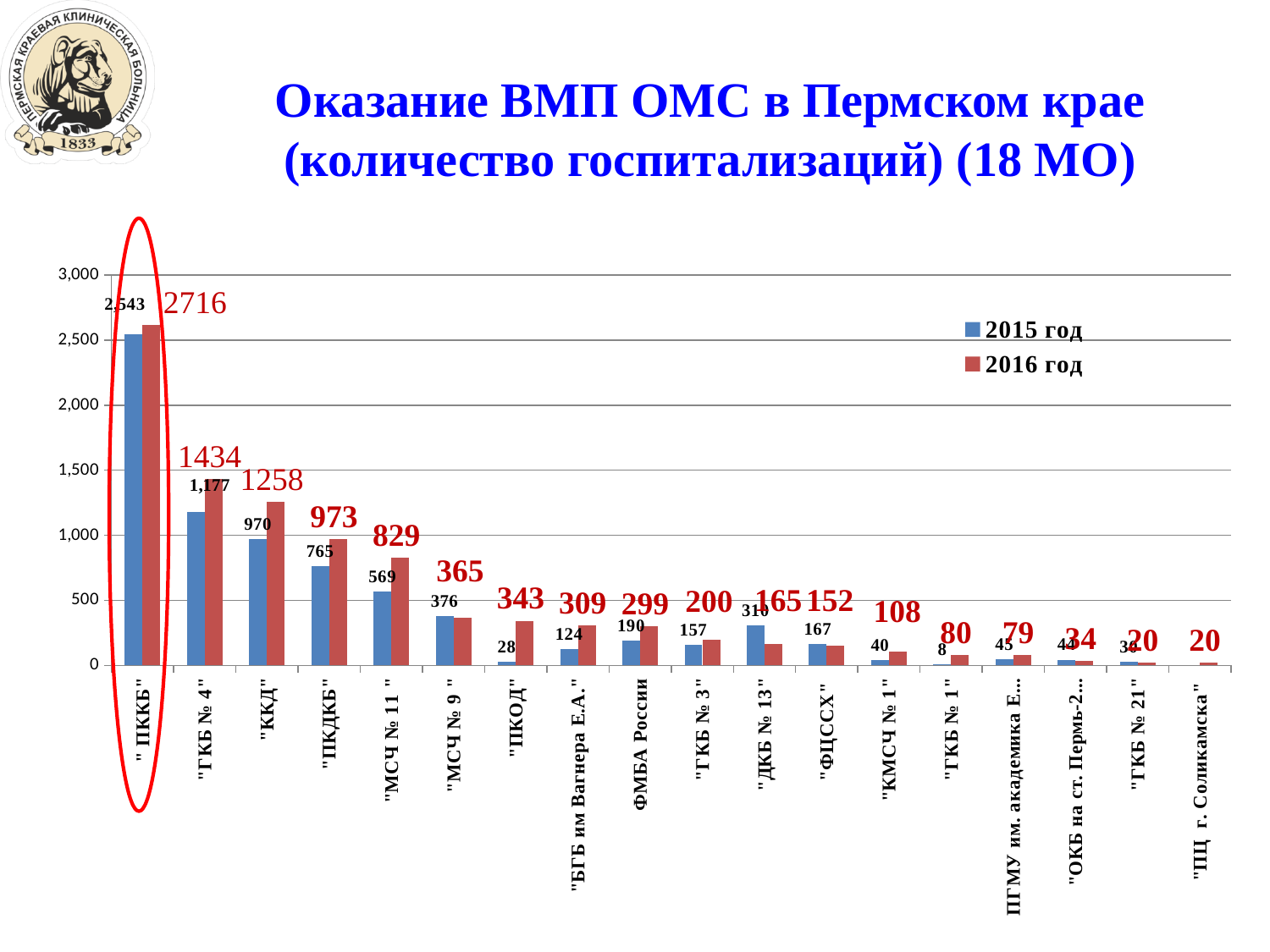
Is the 2016 год value for "ККД" greater or less than 1,000? greater For "МСЧ № 9", which is larger: the 2015 год value or the 2016 год value? 2015 год What kind of chart is shown on the slide? bar chart What is the 2015 год value for "ФЦССХ"? 167 What is the 2015 год value for "ГКБ № 4"? 1,177 Do the 2016 год values rise or fall from left to right along the x axis? fall What is the difference between the 2016 год and 2015 год values for "ПККБ"? 173 Which category has the highest 2016 год value? "ПККБ" What is the 2016 год value for "ПККБ"? 2716 How many categories (medical organisations) are shown on the x axis? 18 What is the difference between the 2016 год and 2015 год values for "ПКОД"? 315 How many series does the legend list? 2